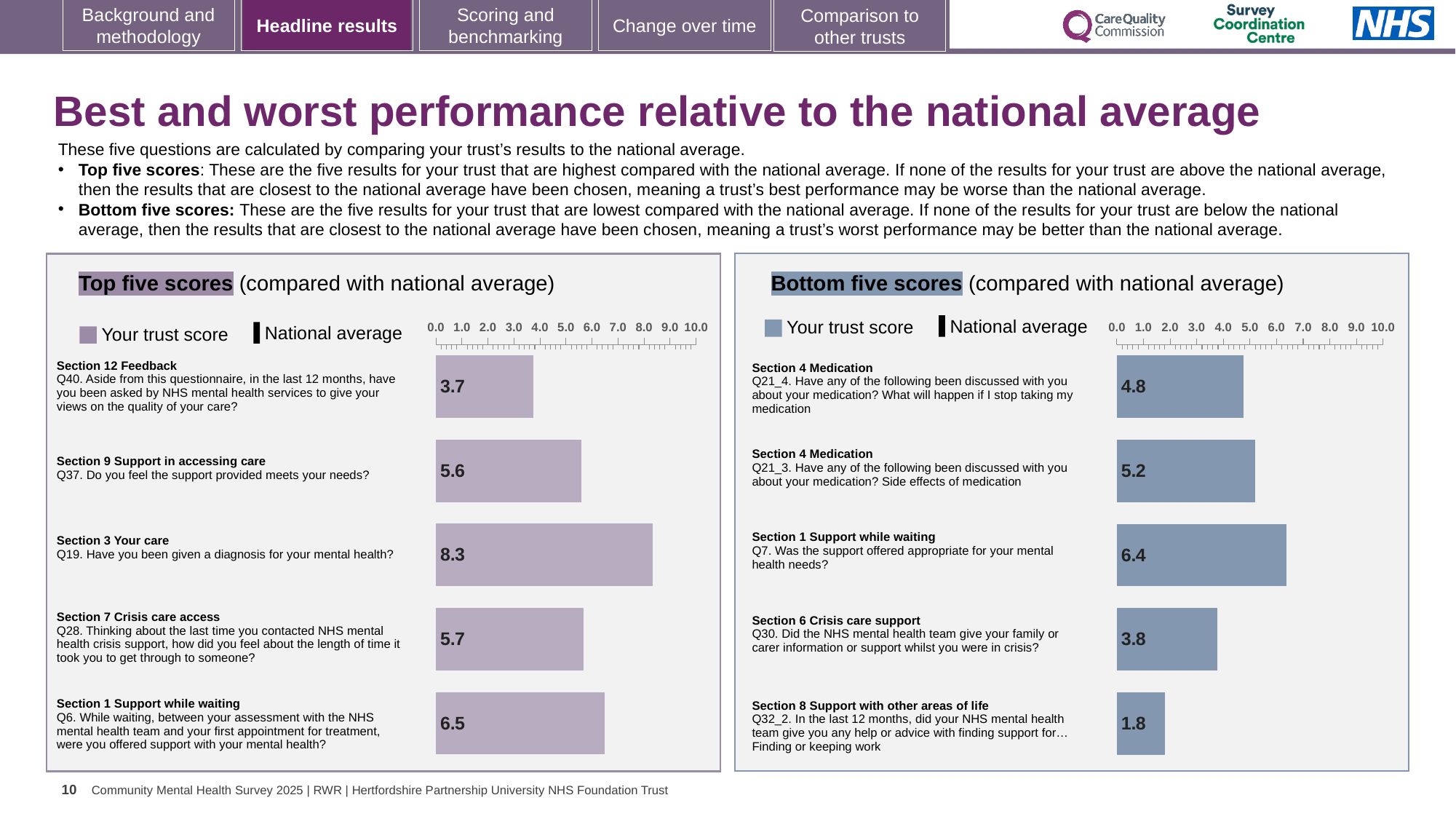
In the Top five scores chart, which question has the highest trust score? Q19 (Section 3 Your care) In the Bottom five scores chart, which question has the lowest trust score? Q32_2 (Section 8 Support with other areas of life) In the Bottom five scores chart, what is the trust score for Q32_2 (help or advice with finding or keeping work)? 1.8 In the Bottom five scores chart, which question has the highest trust score? Q7 (Section 1 Support while waiting) How many series does the legend of the Top five scores chart list? 2 In the Top five scores chart, what is the trust score for Q19 (Have you been given a diagnosis for your mental health?)? 8.3 In the Bottom five scores chart, is the trust score for Q7 greater or less than 5.0? greater In the Bottom five scores chart, what is the difference between the trust scores for Q7 and Q30? 2.6 In the Top five scores chart, what is the difference between the trust scores for Q6 and Q40? 2.8 How many bars are shown in the Top five scores chart? 5 In the Bottom five scores chart, which has the larger trust score, Q7 or Q21_4? Q7 What type of chart is the Bottom five scores chart? Bar chart